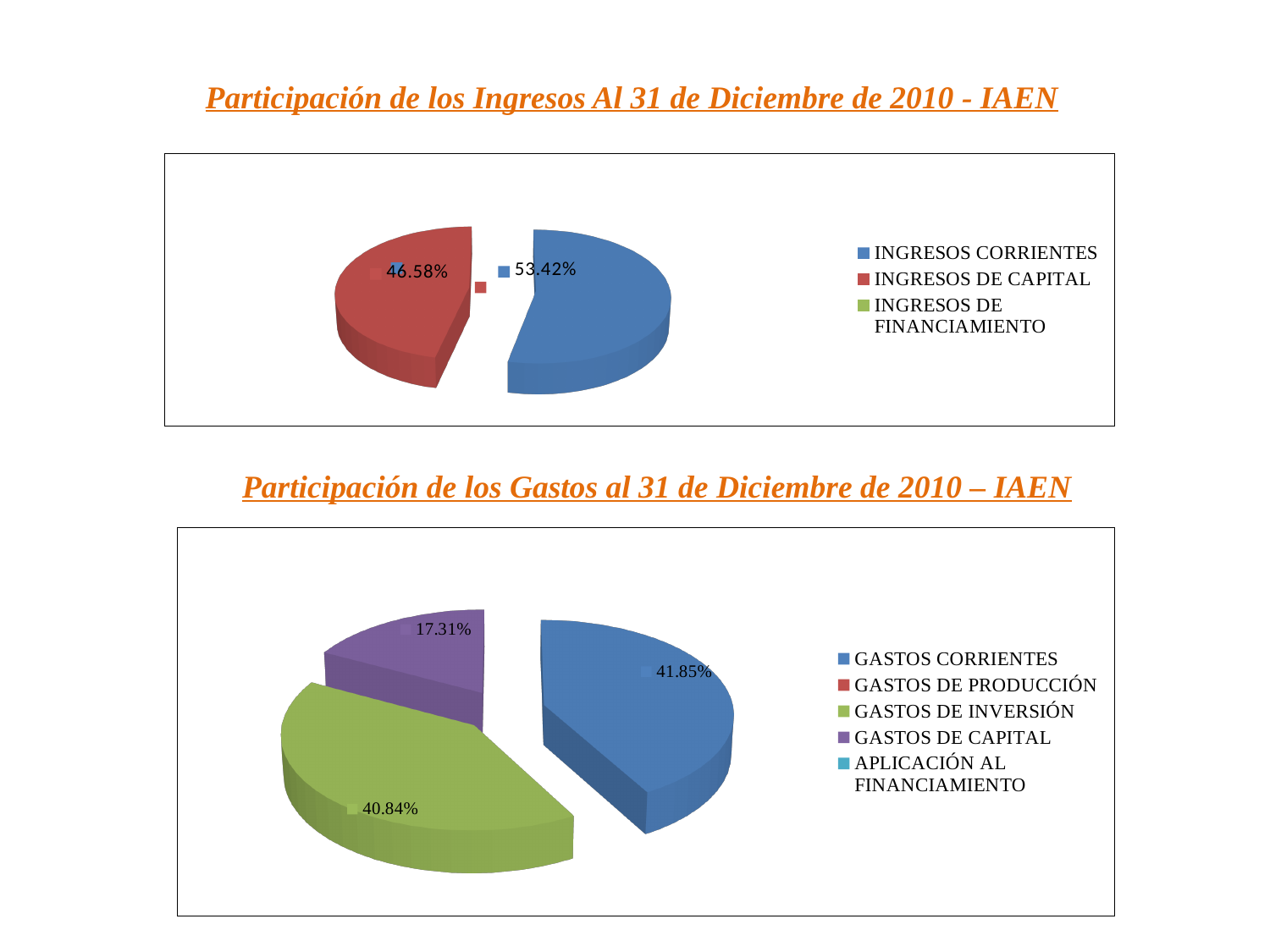
In the chart 'Participación de los Ingresos Al 31 de Diciembre de 2010 - IAEN', what is the difference in percentage points between INGRESOS CORRIENTES and INGRESOS DE CAPITAL? 6.84 What type of chart is 'Participación de los Ingresos Al 31 de Diciembre de 2010 - IAEN'? Pie chart In the chart 'Participación de los Gastos al 31 de Diciembre de 2010 – IAEN', what share is labelled for GASTOS DE INVERSIÓN? 40.84% In the chart 'Participación de los Gastos al 31 de Diciembre de 2010 – IAEN', what share is labelled for GASTOS DE CAPITAL? 17.31% In the chart 'Participación de los Gastos al 31 de Diciembre de 2010 – IAEN', how many categories does the legend list? 5 In the chart 'Participación de los Ingresos Al 31 de Diciembre de 2010 - IAEN', which category has the largest slice? INGRESOS CORRIENTES In the chart 'Participación de los Ingresos Al 31 de Diciembre de 2010 - IAEN', how many categories does the legend list? 3 In the chart 'Participación de los Ingresos Al 31 de Diciembre de 2010 - IAEN', what share is labelled for INGRESOS CORRIENTES? 53.42% In the chart 'Participación de los Ingresos Al 31 de Diciembre de 2010 - IAEN', what share is labelled for INGRESOS DE CAPITAL? 46.58% In the chart 'Participación de los Gastos al 31 de Diciembre de 2010 – IAEN', what share is labelled for GASTOS CORRIENTES? 41.85% In the chart 'Participación de los Gastos al 31 de Diciembre de 2010 – IAEN', which colour represents GASTOS DE CAPITAL? Purple In the chart 'Participación de los Gastos al 31 de Diciembre de 2010 – IAEN', what is the difference in percentage points between GASTOS DE INVERSIÓN and GASTOS DE CAPITAL? 23.53